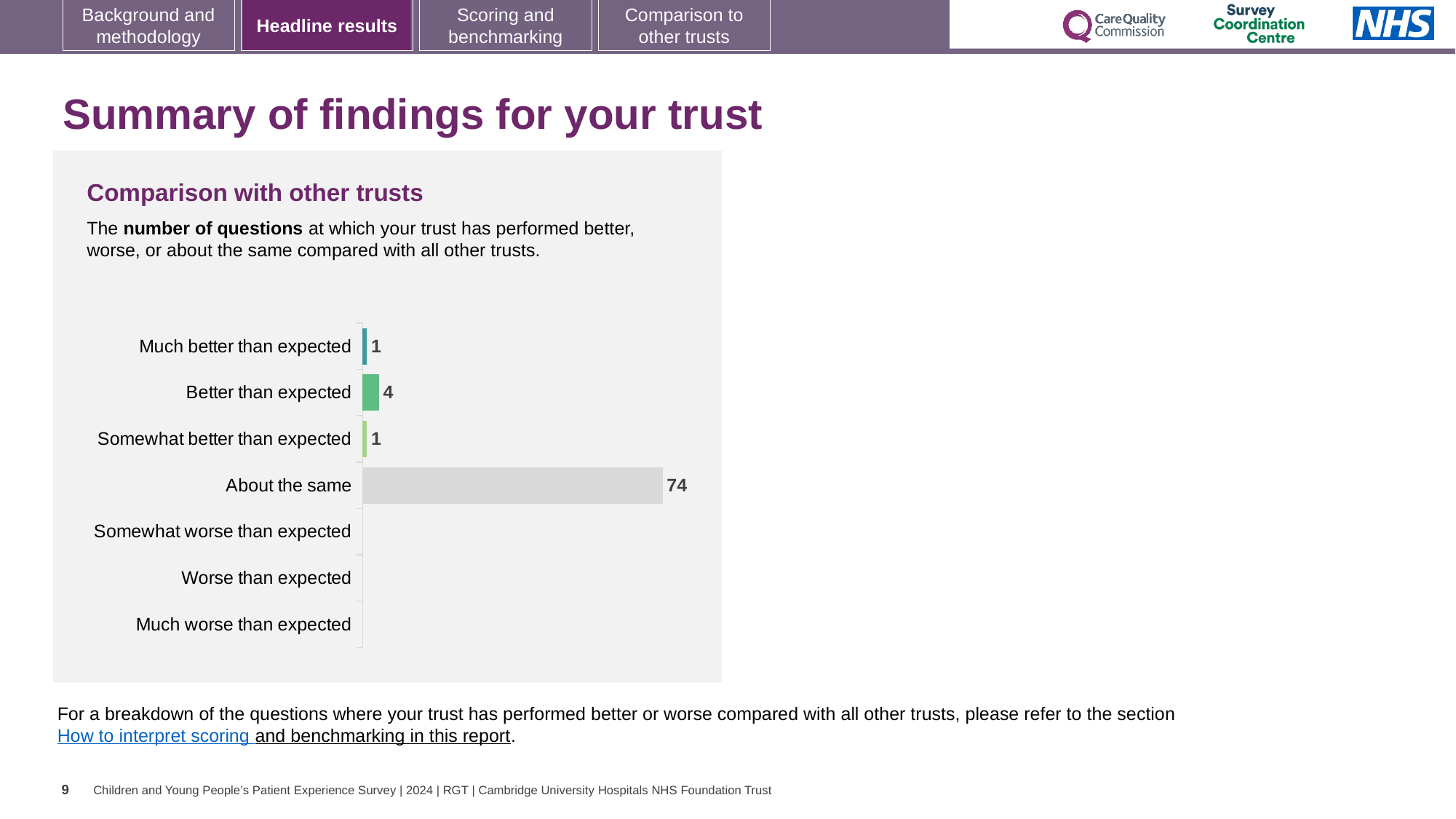
Which is larger: 'Better than expected' or 'Much better than expected'? Better than expected What kind of chart is shown on the slide? Bar chart How many categories are listed on the chart's axis? 7 What colour is the bar for 'About the same'? Grey Which category has the highest number of questions? About the same How many questions were rated 'About the same'? 74 What is the value for 'Much better than expected'? 1 What is the title of the chart section? Comparison with other trusts What is the total number of questions across the three 'better than expected' categories? 6 What is the difference between the 'About the same' value and the 'Better than expected' value? 70 What is the value for 'Better than expected'? 4 What is the value for 'Somewhat better than expected'? 1